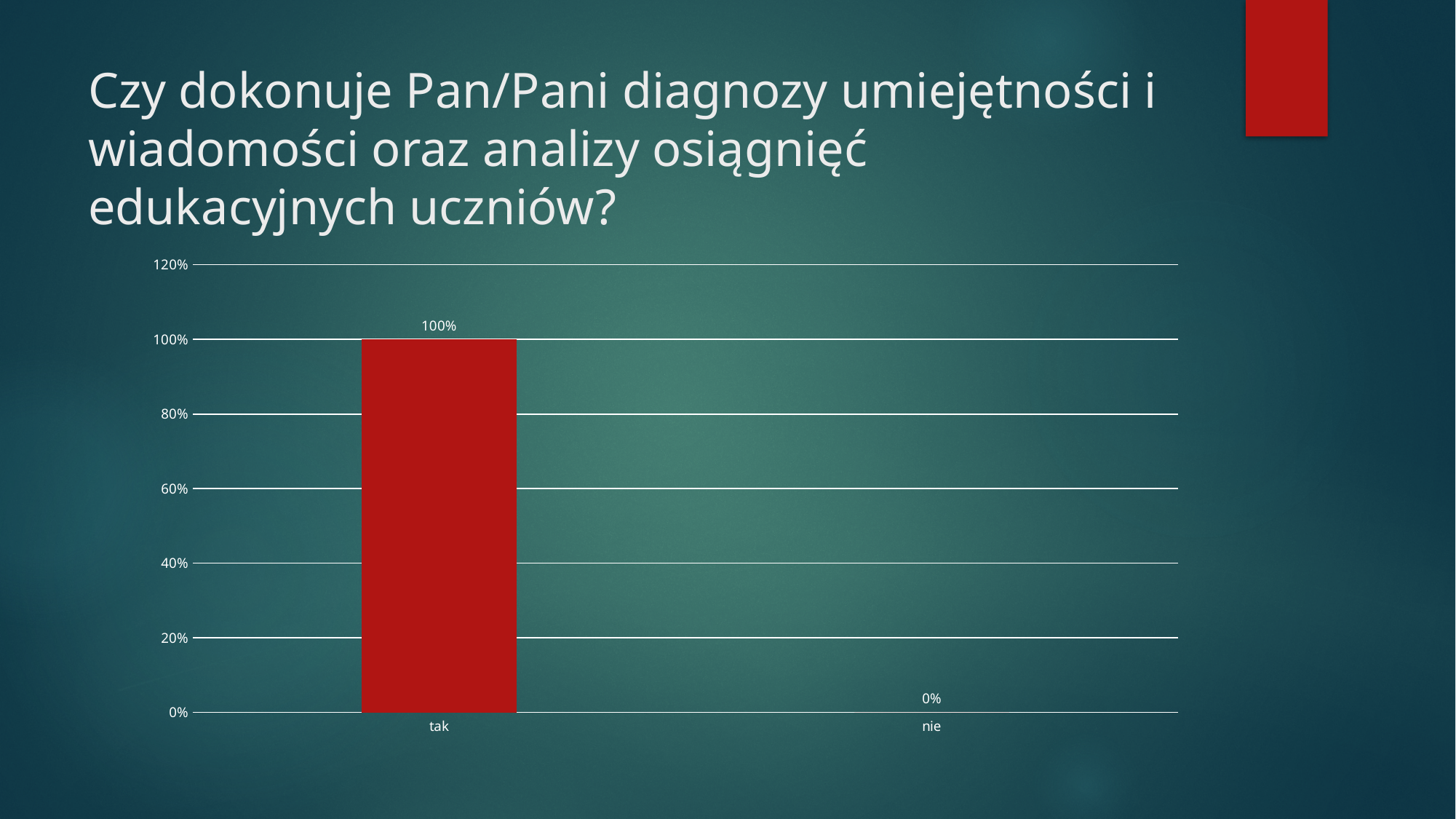
What kind of chart is shown on the slide? bar chart What is the highest tick value shown on the y axis? 120% Which is larger, the value for "tak" or the value for "nie"? tak What is the difference between the values for "tak" and "nie"? 100% Which category has the highest value? tak Which category has the lowest value? nie What is the value for "nie"? 0% What is the value for "tak"? 100% How many categories are shown on the x axis? 2 Do the values rise or fall from "tak" to "nie"? fall Is the value for "tak" greater or less than 80%? greater What colour is the bar for "tak"? red